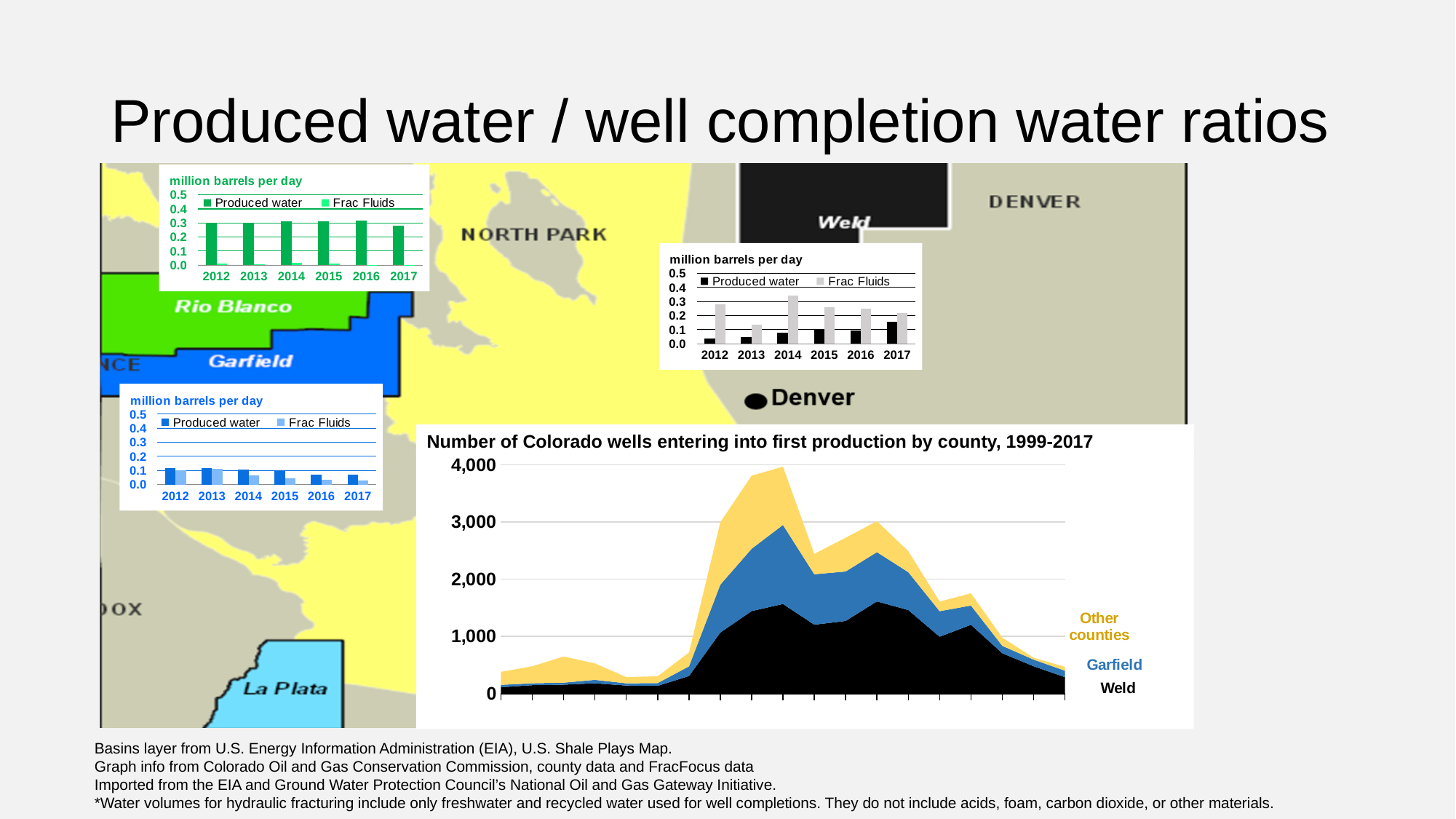
In the green bar chart at the top left, is the Produced water value for 2016 greater or less than 0.2? greater What kind of chart is the green chart at the top left of the map? Bar chart In the blue bar chart at the bottom left, do the Produced water values rise or fall from 2013 to 2017? fall In the black-and-grey bar chart at the top right, is the Produced water value for 2012 greater or less than 0.1? less How many series does the legend of the "Number of Colorado wells entering into first production by county, 1999-2017" chart list? 3 In the "Number of Colorado wells entering into first production by county, 1999-2017" chart, which county is shown as the black bottom layer? Weld In the black-and-grey bar chart at the top right, in which year is the Frac Fluids value highest? 2014 How many years are shown on the x axis of the green bar chart at the top left? 6 In the black-and-grey bar chart at the top right, do the Produced water values rise or fall from 2012 to 2017? rise What kind of chart is the large chart titled "Number of Colorado wells entering into first production by county, 1999-2017"? Stacked area chart In the green bar chart at the top left, which series is larger in every year, Produced water or Frac Fluids? Produced water In the "Number of Colorado wells entering into first production by county, 1999-2017" chart, is the highest total number of wells greater or less than 3,000? greater